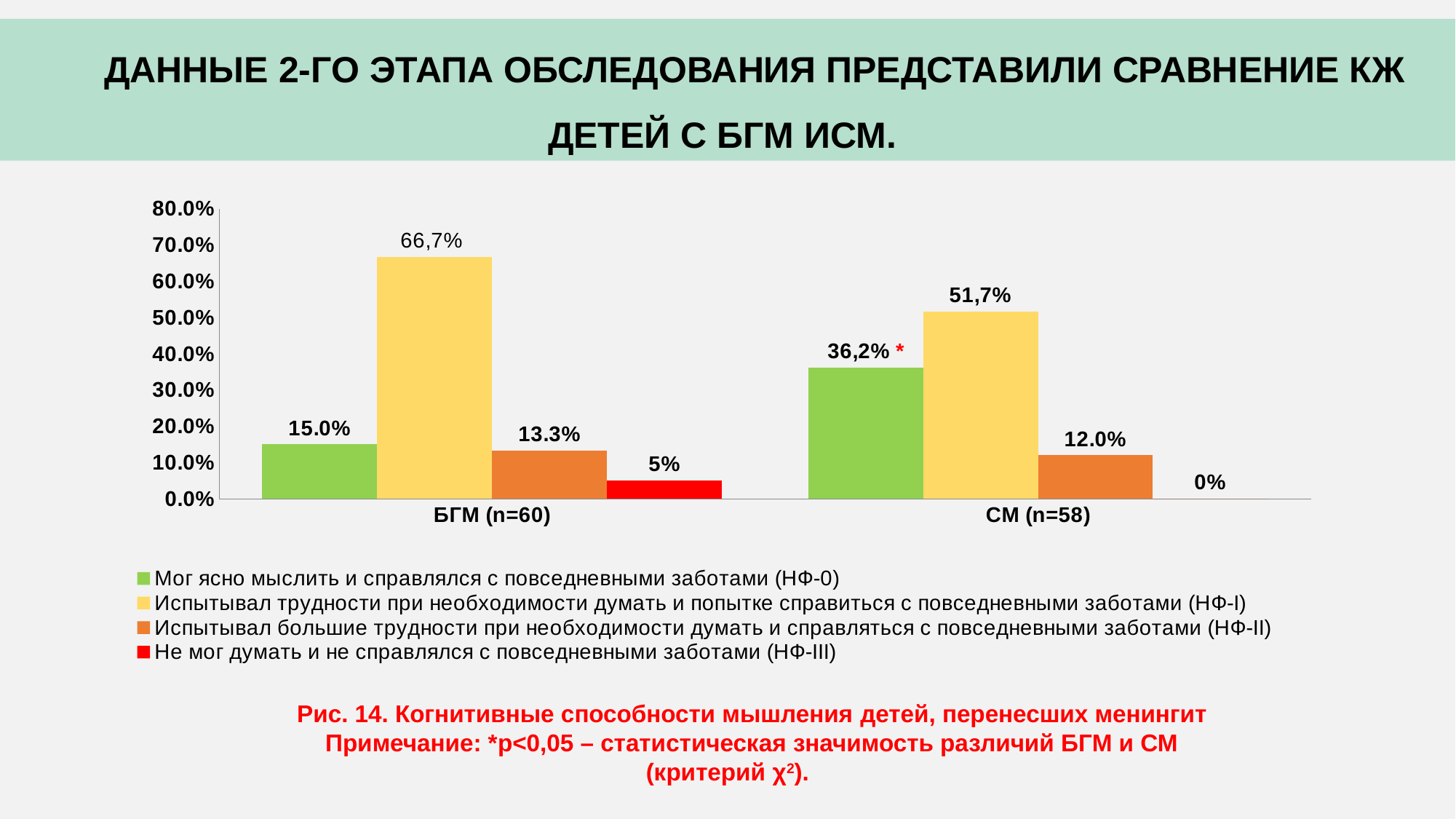
What is the value for НФ-0 (Мог ясно мыслить) in the СМ (n=58) group? 36,2% What is the value for НФ-II (Испытывал большие трудности) in the СМ (n=58) group? 12.0% Which group has the larger value for НФ-0 (Мог ясно мыслить): БГМ (n=60) or СМ (n=58)? СМ (n=58) What is the difference between the НФ-0 values for СМ (n=58) and БГМ (n=60)? 21.2% Which colour represents the НФ-III series (Не мог думать и не справлялся с повседневными заботами)? red What is the value for НФ-III (Не мог думать) in the БГМ (n=60) group? 5% What type of chart is shown on the slide? bar chart What is the value for НФ-I (Испытывал трудности при необходимости думать) in the БГМ (n=60) group? 66,7% Which series has the highest value in the СМ (n=58) group? Испытывал трудности при необходимости думать и попытке справиться с повседневными заботами (НФ-I) How many series does the legend list? 4 Which series has the lowest value in the БГМ (n=60) group? Не мог думать и не справлялся с повседневными заботами (НФ-III) How many categories are shown on the x axis? 2